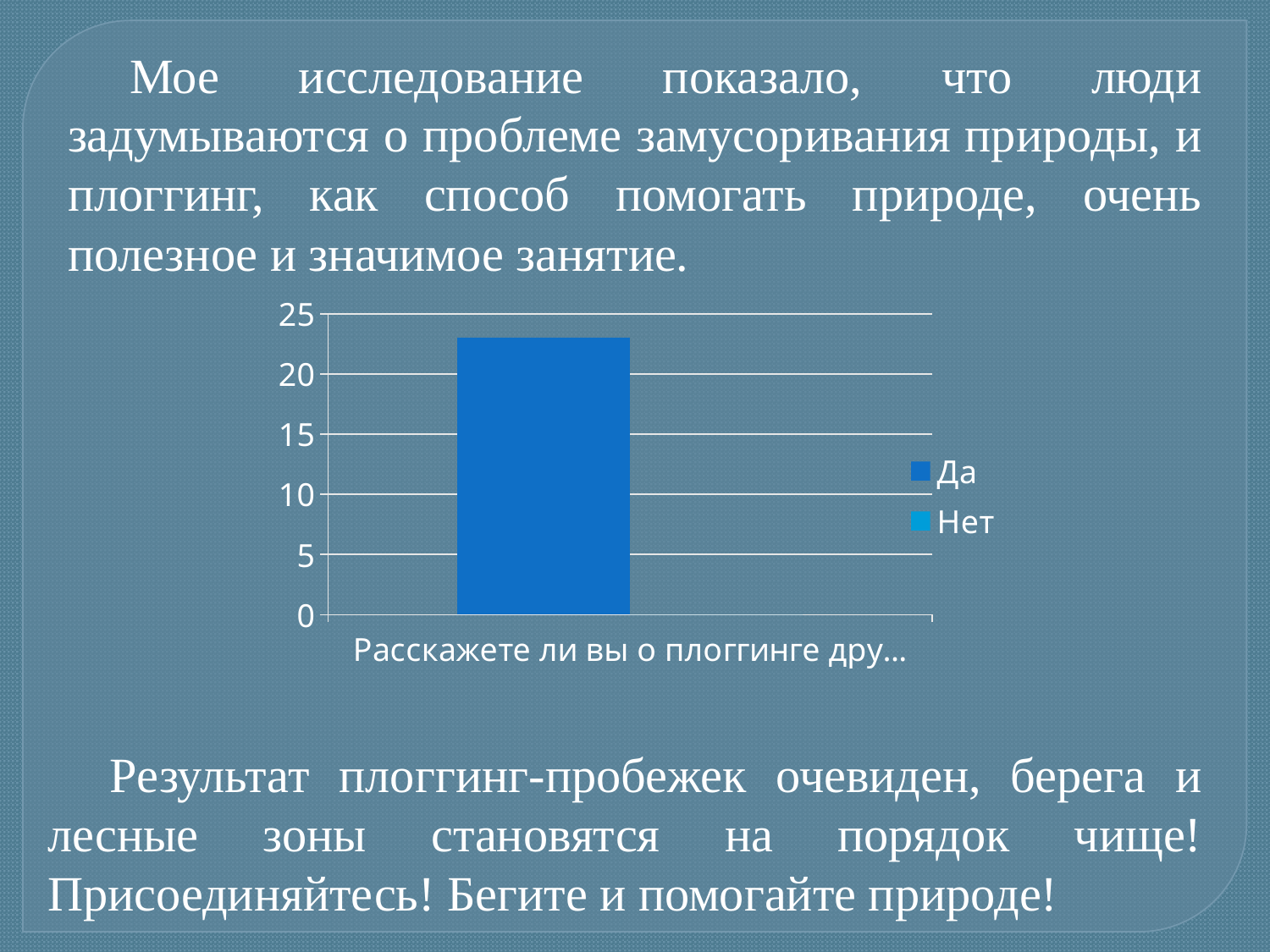
Is the value for Да greater or less than 15? greater Is the value for Да greater or less than 20? greater Which series has the larger value, Да or Нет? Да Is the value for Да greater or less than 25? less Which series has the lowest value in the chart? Нет What is the highest value shown on the chart's vertical axis? 25 How many series does the chart legend list? 2 What kind of chart is shown on the slide? bar chart What are the two entries in the chart legend? Да and Нет How many categories are shown on the horizontal axis of the chart? 1 Which series has the highest value in the chart? Да